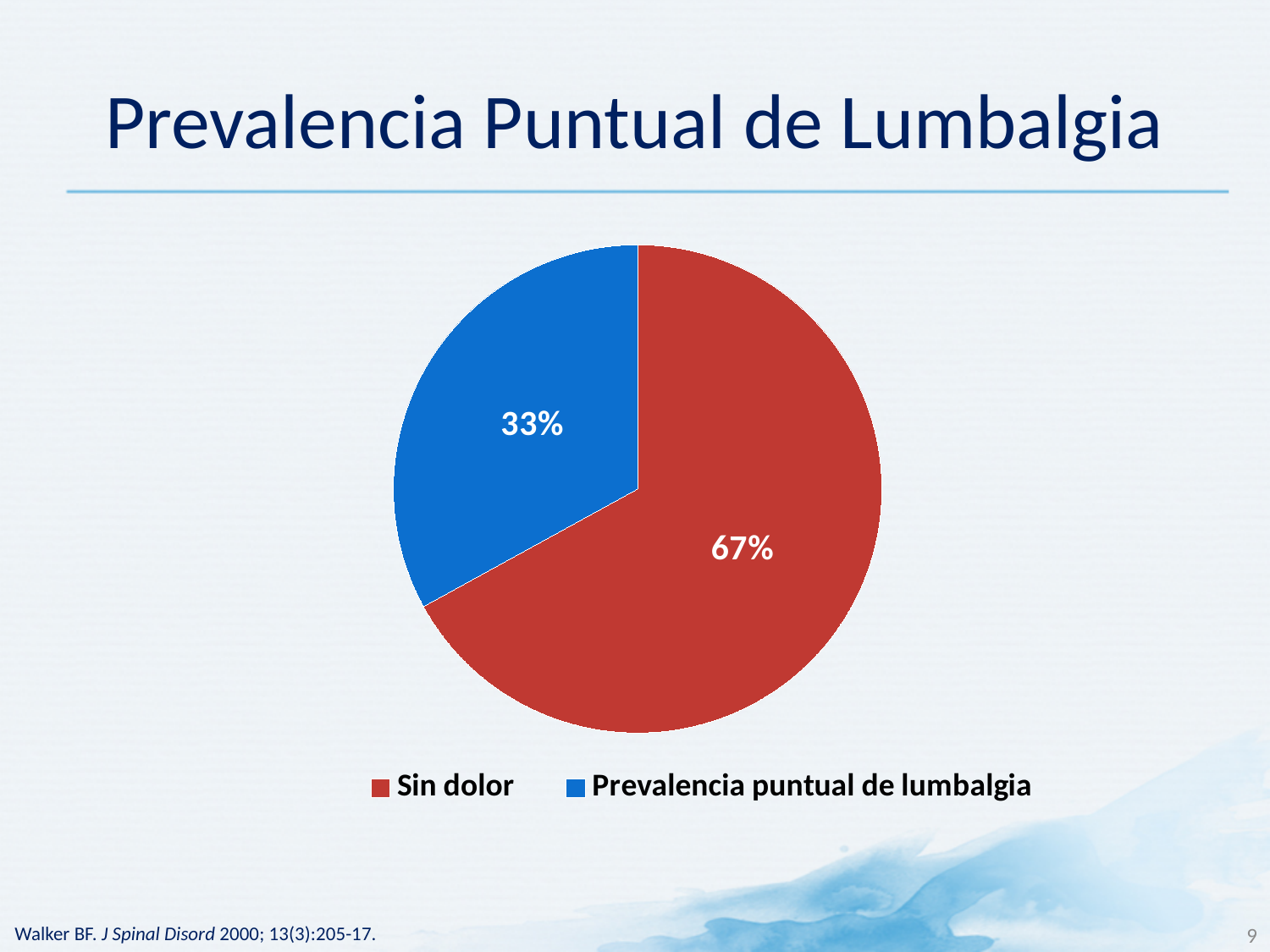
What share of the pie does the 'Sin dolor' slice represent? 67% What is the title of the slide containing the pie chart? Prevalencia Puntual de Lumbalgia What kind of chart is shown on the slide? pie chart Which slice is the smallest in the pie chart? Prevalencia puntual de lumbalgia Which slice is the largest in the pie chart? Sin dolor What is the difference in percentage points between the 'Sin dolor' slice and the 'Prevalencia puntual de lumbalgia' slice? 34 What share of the pie does the 'Prevalencia puntual de lumbalgia' slice represent? 33% Which is larger: the 'Sin dolor' slice or the 'Prevalencia puntual de lumbalgia' slice? Sin dolor How many entries does the legend list? 2 How many slices does the pie chart have? 2 What colour is the 'Prevalencia puntual de lumbalgia' slice? blue